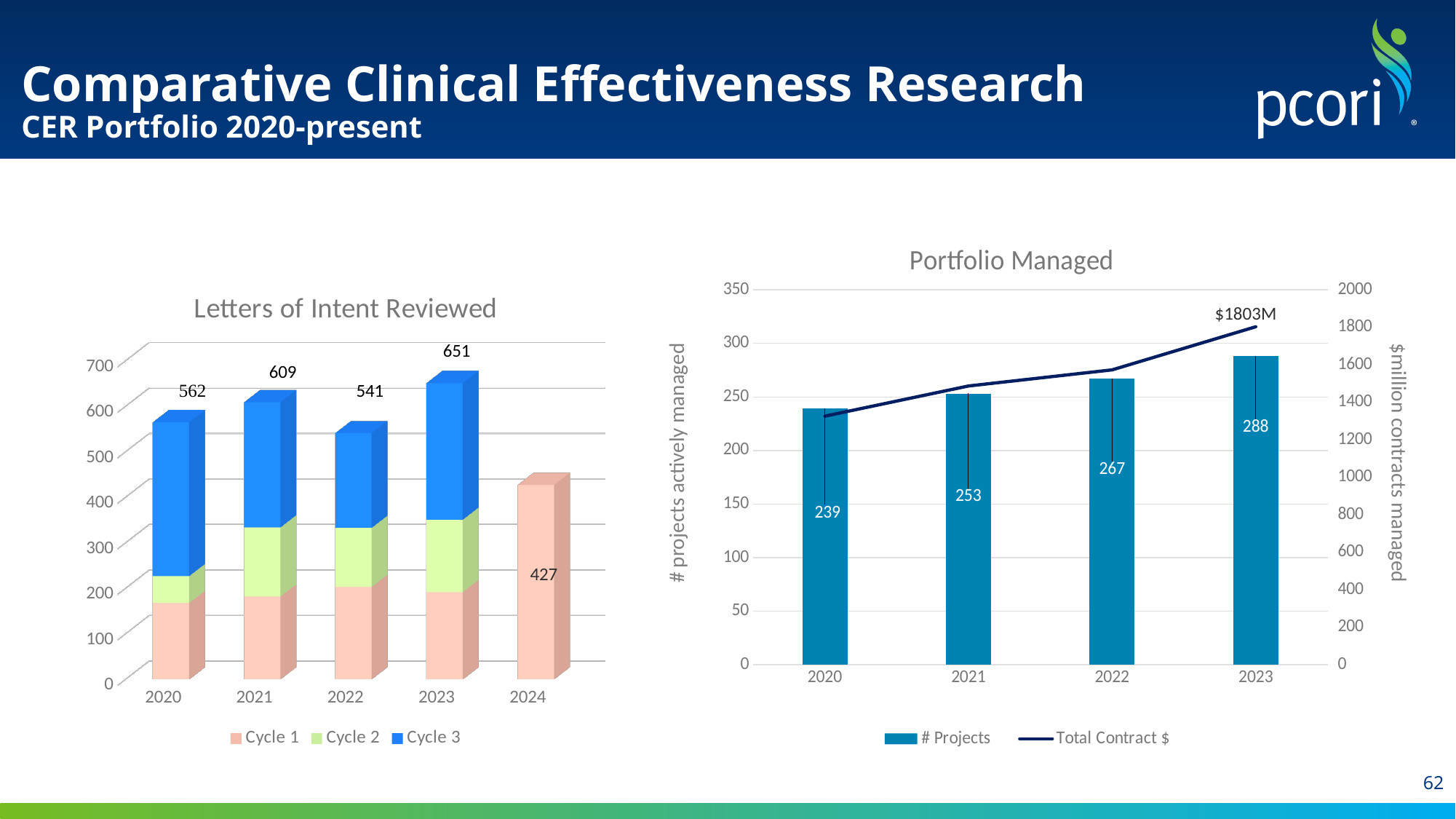
In the Portfolio Managed chart, is the Total Contract $ value for 2020 greater or less than 1600? less In the Letters of Intent Reviewed chart, how many series does the legend list? 3 In the Letters of Intent Reviewed chart, what is the total for 2021? 609 In the Portfolio Managed chart, what is the Total Contract $ value labeled for 2023? $1803M In the Portfolio Managed chart, what is the difference in # Projects between 2023 and 2020? 49 In the Letters of Intent Reviewed chart, what is the total for 2023? 651 In the Portfolio Managed chart, do the # Projects values rise or fall from 2020 to 2023? rise In the Portfolio Managed chart, how many projects were actively managed in 2022? 267 In the Letters of Intent Reviewed chart, how many years are shown on the x axis? 5 In the Letters of Intent Reviewed chart, which year has the highest total? 2023 In the Letters of Intent Reviewed chart, what is the difference between the 2021 total and the 2022 total? 68 In the Letters of Intent Reviewed chart, which year has the lowest total? 2024